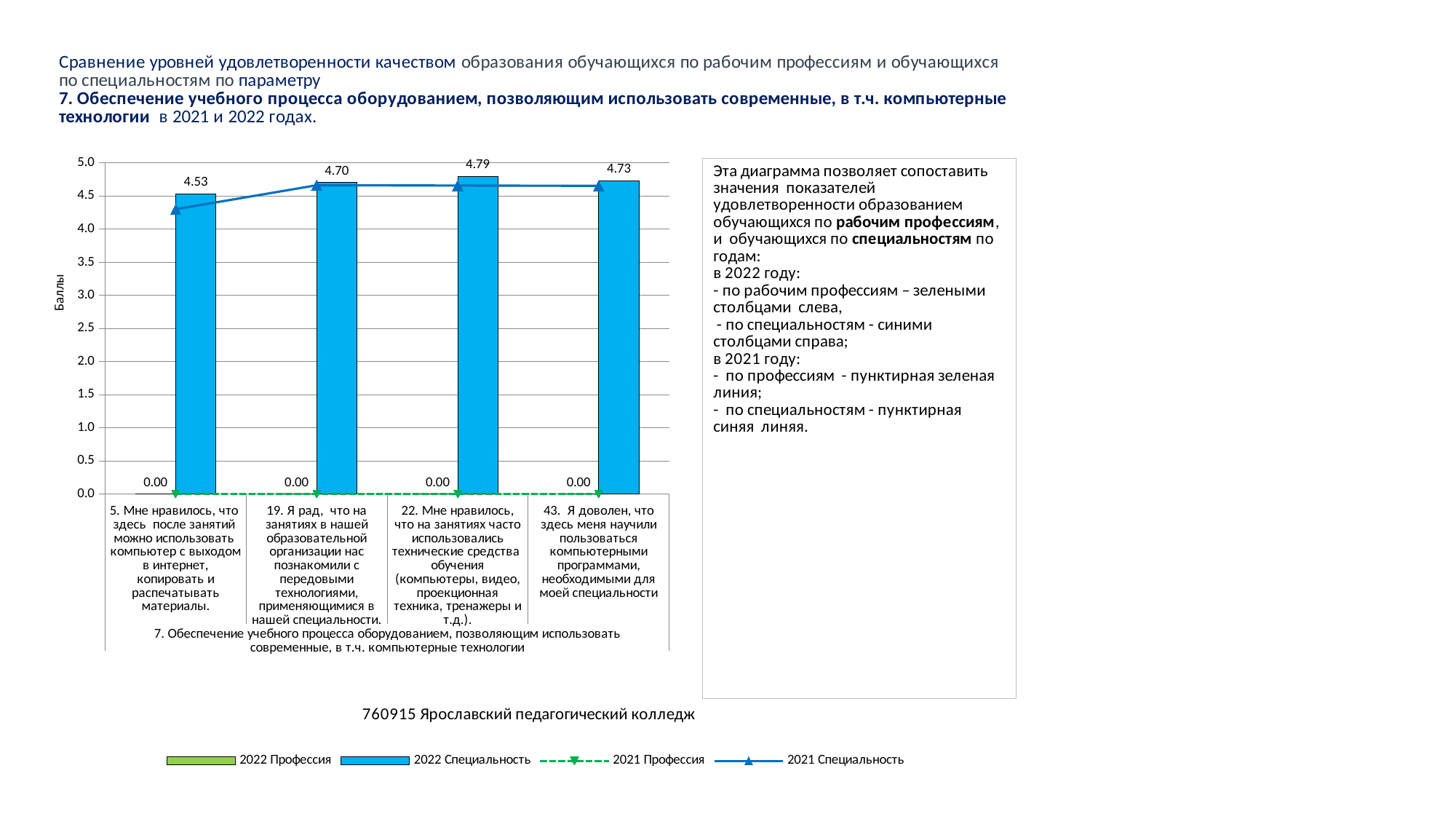
What is the difference between the 2022 Специальность values for item 22 and item 5? 0.26 What is the 2022 Специальность value for item 43 (Я доволен, что здесь меня научили пользоваться компьютерными программами...)? 4.73 What is the 2022 Специальность value for item 5 (Мне нравилось, что здесь после занятий можно использовать компьютер с выходом в интернет...)? 4.53 How many categories (survey items) are shown on the x axis? 4 What is the 2022 Специальность value for item 19 (Я рад, что на занятиях в нашей образовательной организации нас познакомили с передовыми технологиями...)? 4.70 Which is larger: the 2022 Специальность value for item 19 or for item 43? item 43 (4.73) Which item has the lowest 2022 Специальность value? 5. Мне нравилось, что здесь после занятий можно использовать компьютер с выходом в интернет What value is labelled for the 2022 Профессия series at item 22? 0.00 How many series does the legend list? 4 What is the label on the vertical axis? Баллы Which item has the highest 2022 Специальность value? 22. Мне нравилось, что на занятиях часто использовались технические средства обучения Is the 2021 Специальность value for item 5 greater or less than 4.0? greater